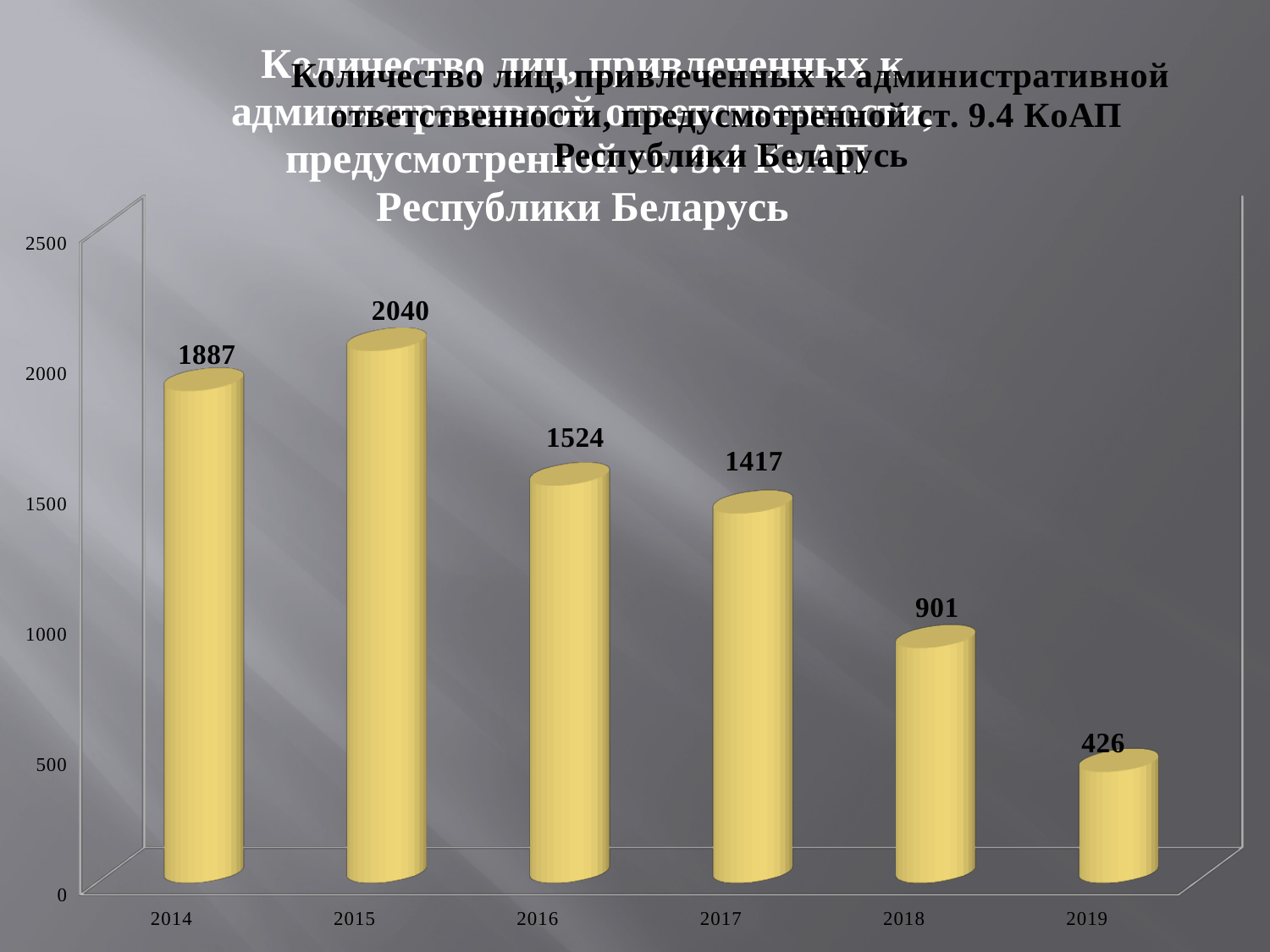
Which year has the highest value? 2015 How many years are shown on the x axis? 6 What is the value for 2017? 1417 What is the value for 2019? 426 Do the values rise or fall from 2015 to 2019? fall What kind of chart is shown on the slide? bar chart What is the difference between the values for 2018 and 2019? 475 Which year has the lowest value? 2019 What is the value for 2014? 1887 What is the difference between the values for 2015 and 2016? 516 Is the value for 2018 greater or less than 1000? less Which is larger, the value for 2014 or the value for 2016? 2014